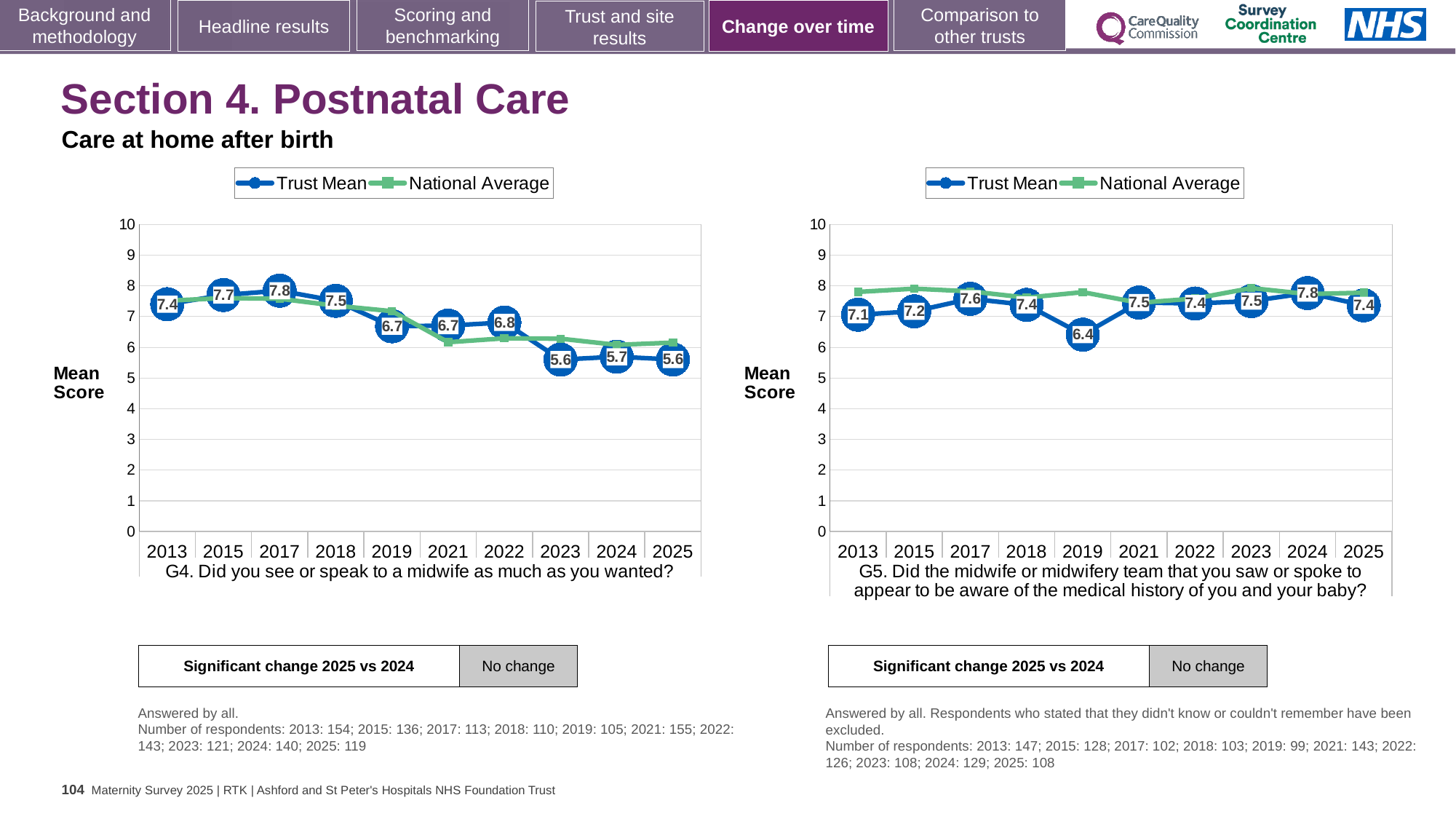
In the G4 chart (left), what is the Trust Mean for 2017? 7.8 In the G4 chart (left), what is the difference between the Trust Mean in 2013 and in 2025? 1.8 In the G4 chart (left), which year has the highest Trust Mean? 2017 In the G4 chart (left), is the National Average for 2025 greater or less than 7? less What type of chart is the G4 chart (left)? Line chart In the G5 chart (right), which is larger: the Trust Mean for 2024 or for 2025? 2024 In the G5 chart (right), is the National Average for 2013 greater or less than 7? greater How many years are plotted on the x axis of the G4 chart (left)? 10 In the G5 chart (right), what is the Trust Mean for 2019? 6.4 How many series does the legend of the G5 chart (right) list? 2 In the G4 chart (left), does the Trust Mean generally rise or fall from 2017 to 2025? Fall In the G5 chart (right), which year has the lowest Trust Mean? 2019